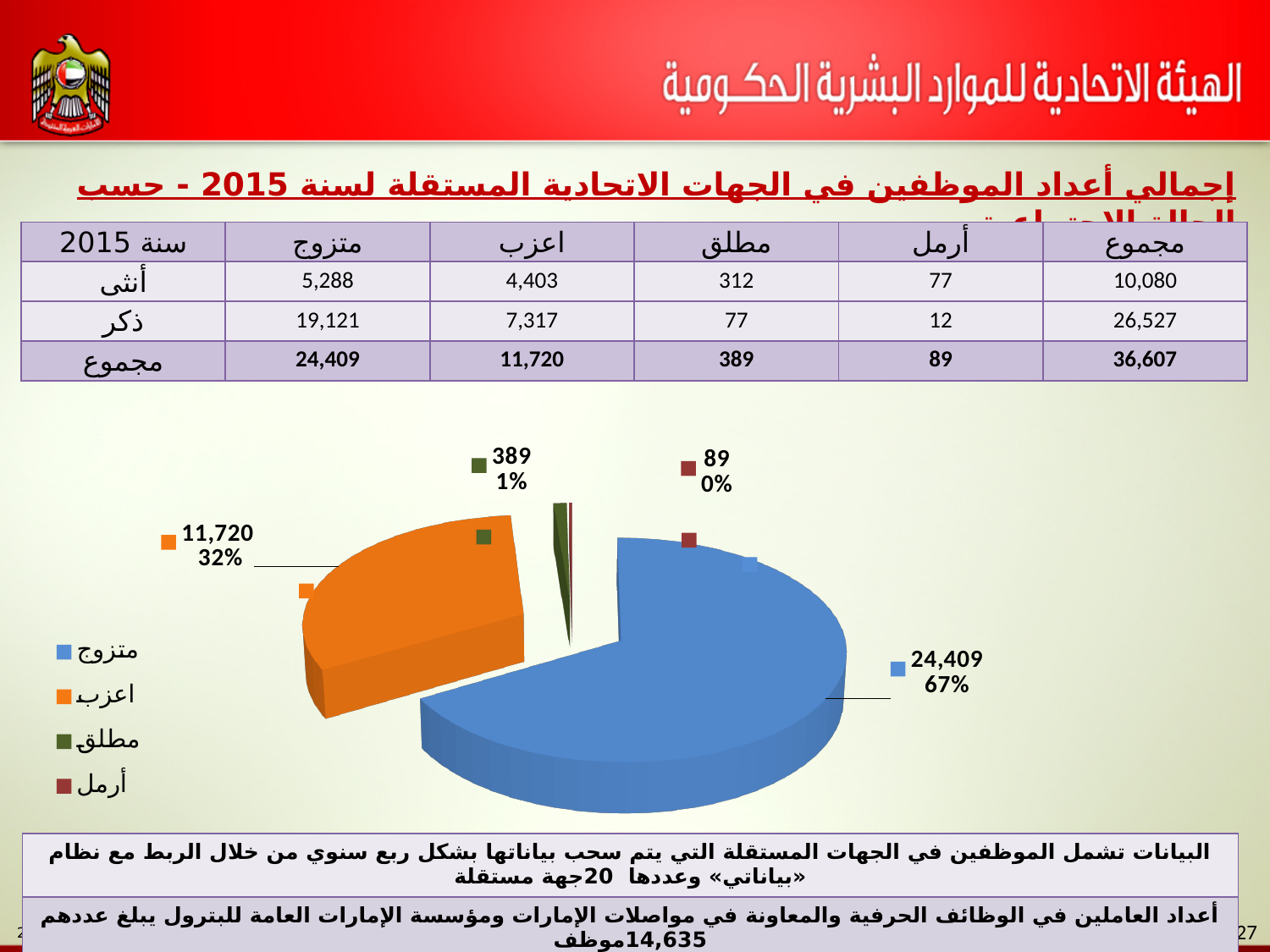
Which is larger in the pie chart, مطلق or أرمل? مطلق How many slices does the pie chart have? 4 What is the value shown for اعزب in the pie chart? 11,720 What is the value shown for أرمل in the pie chart? 89 What kind of chart is shown on the slide? pie chart What is the value shown for متزوج in the pie chart? 24,409 How many entries does the pie chart's legend list? 4 What is the difference between the values for متزوج and اعزب in the pie chart? 12,689 Which category has the smallest slice in the pie chart? أرمل What is the value shown for مطلق in the pie chart? 389 Which category has the largest slice in the pie chart? متزوج What percentage share of the pie does اعزب have? 32%